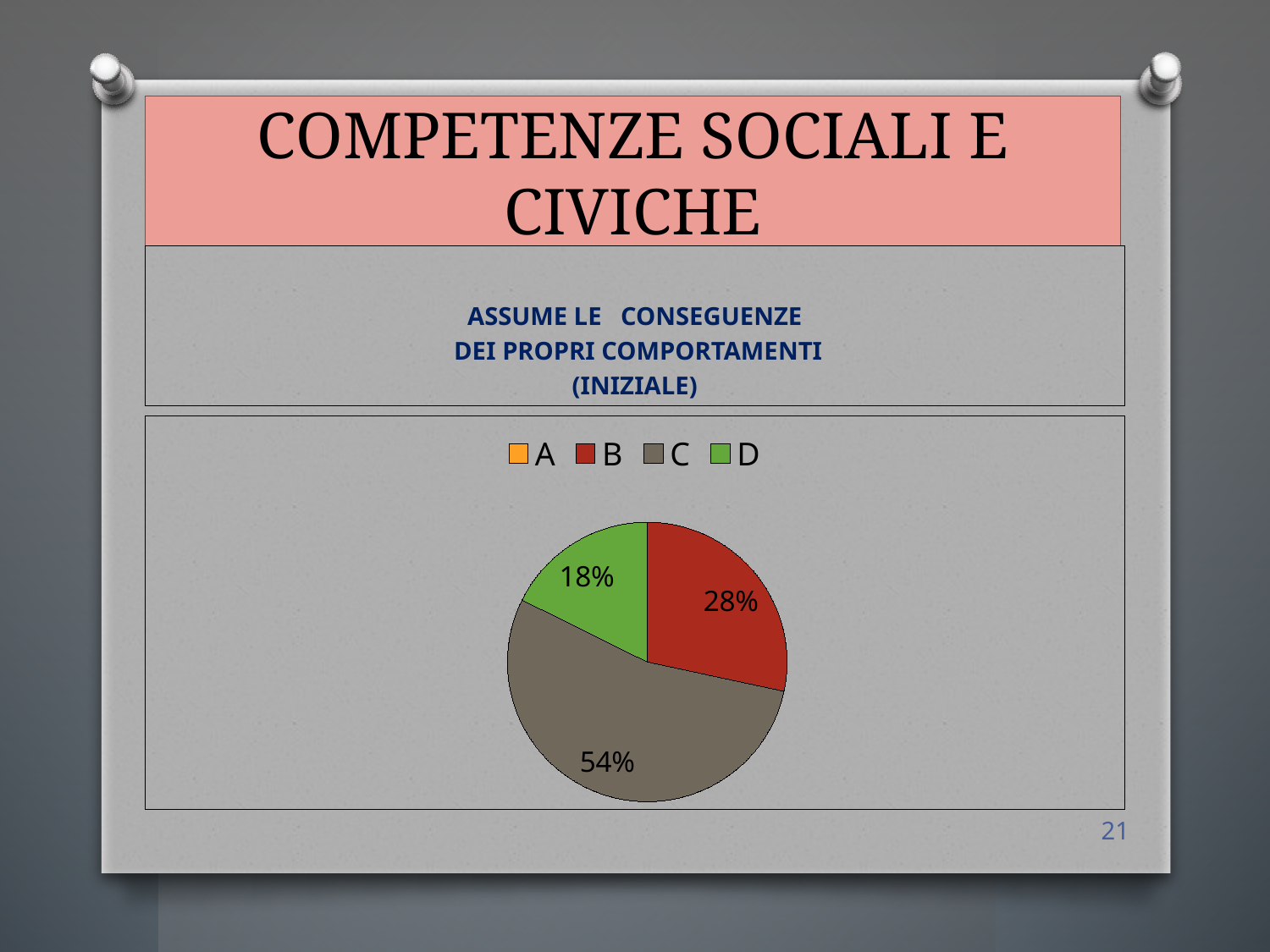
Among the slices with a percentage label, which category has the smallest share? D How many slices of the pie chart have a percentage label? 3 What percentage of the pie chart does category D represent? 18% What colour is used for category D in the pie chart? Green What percentage of the pie chart does category B represent? 28% What type of chart is shown on the slide? Pie chart What percentage of the pie chart does category C represent? 54% Which category has the largest slice of the pie chart? C What is the difference in percentage points between the slices for C and B? 26 Which slice is larger, B or D? B How many categories does the legend of the pie chart list? 4 What is the difference in percentage points between the slices for B and D? 10